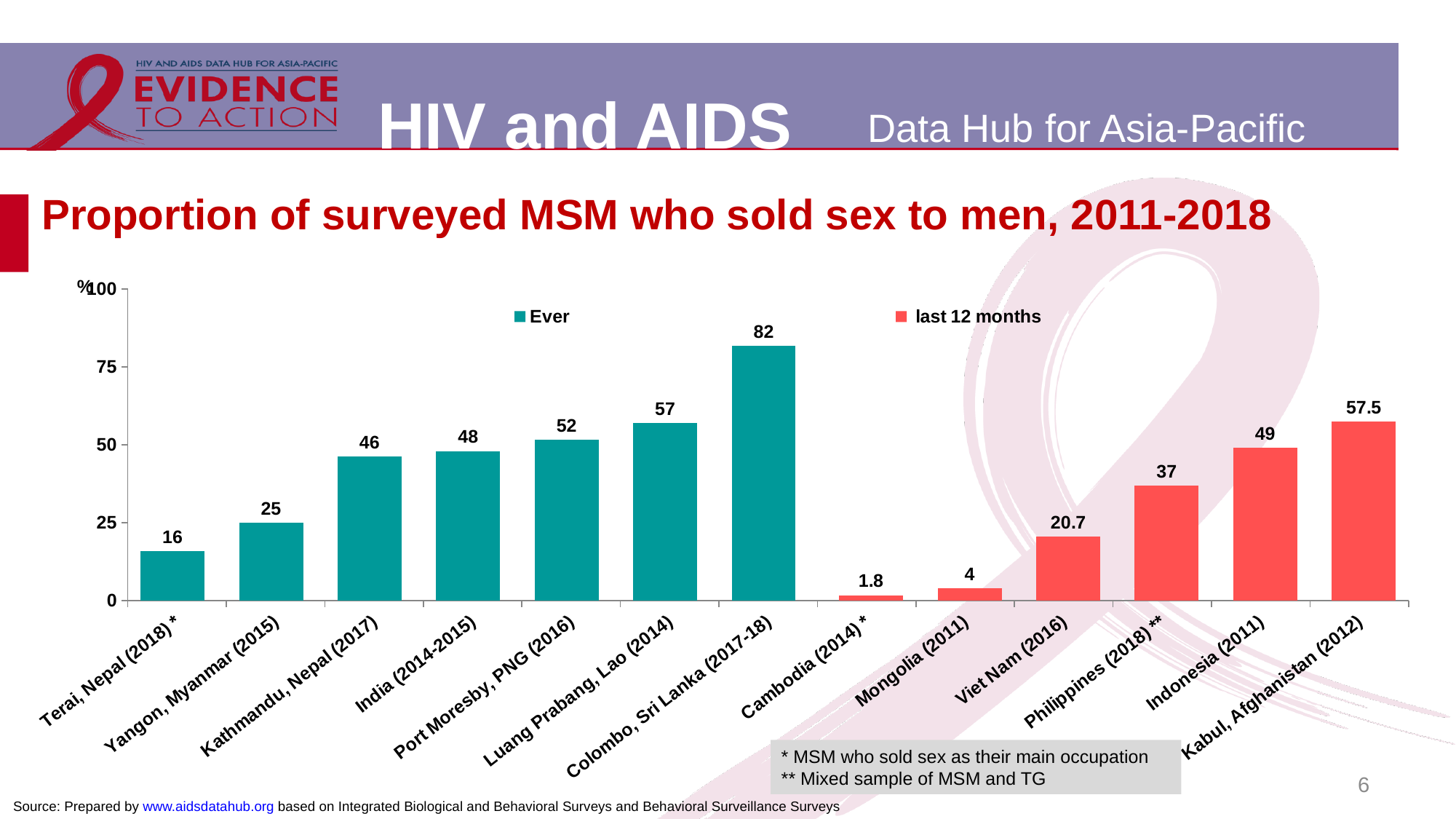
Which is larger, the value for Indonesia (2011) or the value for India (2014-2015)? Indonesia (2011) What is the value for Viet Nam (2016)? 20.7 Which category has the lowest value on the chart? Cambodia (2014)* What is the value for Colombo, Sri Lanka (2017-18)? 82 Which category has the highest value on the chart? Colombo, Sri Lanka (2017-18) Which series does the red colour represent in the legend? last 12 months How many series does the legend list? 2 What kind of chart is shown on the slide? bar chart What is the difference between the values for Luang Prabang, Lao (2014) and Yangon, Myanmar (2015)? 32 What is the value for Kabul, Afghanistan (2012)? 57.5 How many categories are shown on the x axis? 13 Is the value for Philippines (2018)** greater or less than 25? greater